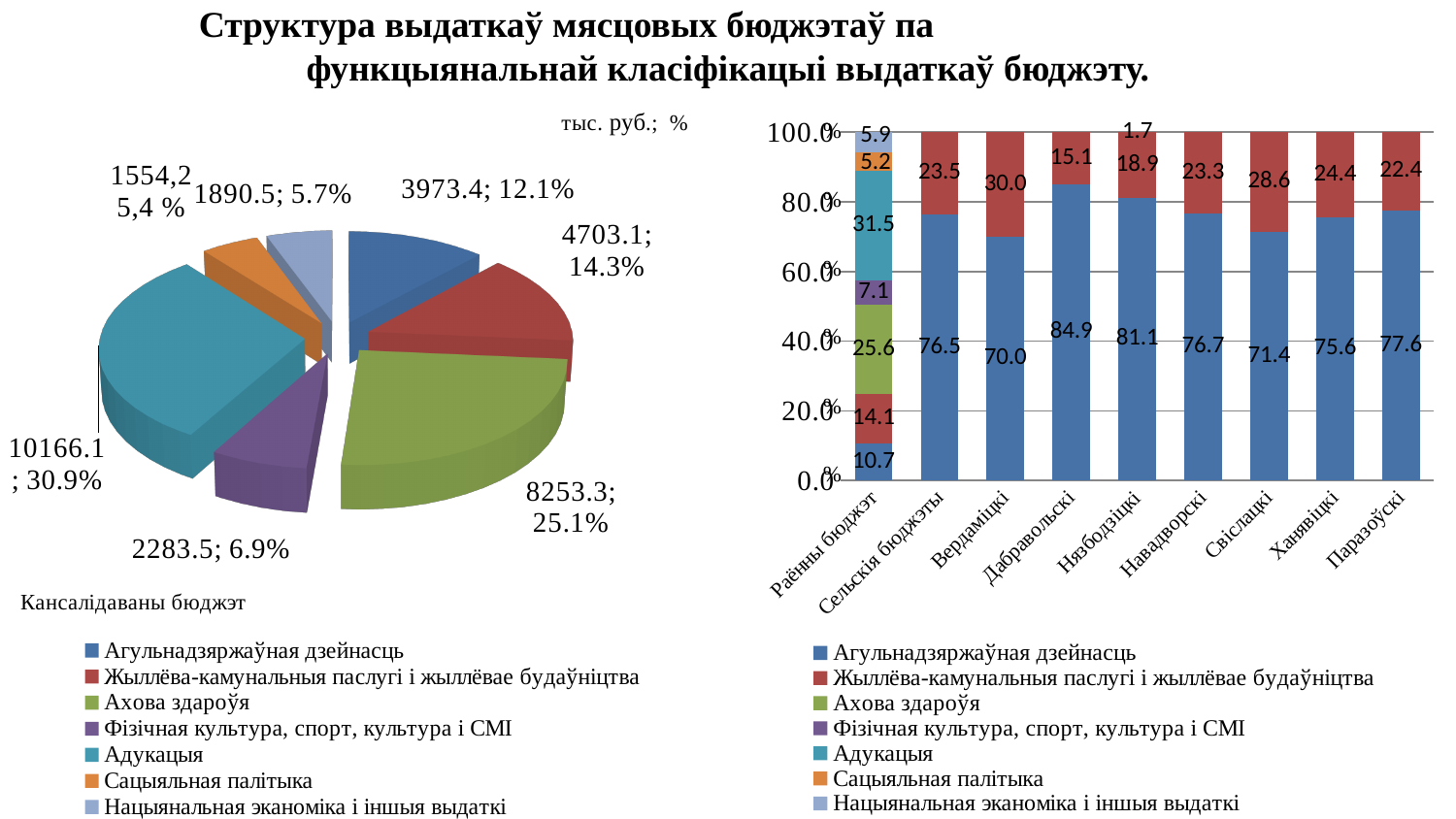
On the bar chart on the right, which has the larger value for Агульнадзяржаўная дзейнасць: Свiслацкi or Ханявiцкi? Ханявiцкi On the pie chart on the left, what value is shown for Адукацыя? 10166.1; 30.9% What kind of chart is the chart on the left of the slide? Pie chart On the bar chart on the right, what is the value for Агульнадзяржаўная дзейнасць for Дабравольскi? 84.9 On the pie chart on the left, what share of the pie does Ахова здароўя take? 25.1% On the bar chart on the right, how many budget categories are shown on the x axis? 9 On the pie chart on the left, which category has the largest slice? Адукацыя On the bar chart on the right, how many series does the legend list? 7 What kind of chart is the chart on the right of the slide? Stacked bar chart On the bar chart on the right, what is the value for Адукацыя in Раённы бюджэт? 31.5 On the bar chart on the right, what is the difference between the Жыллёва-камунальныя паслугі values for Сельскія бюджэты and Вердамiцкi? 6.5 On the bar chart on the right, which budget has the highest value for Агульнадзяржаўная дзейнасць? Дабравольскi